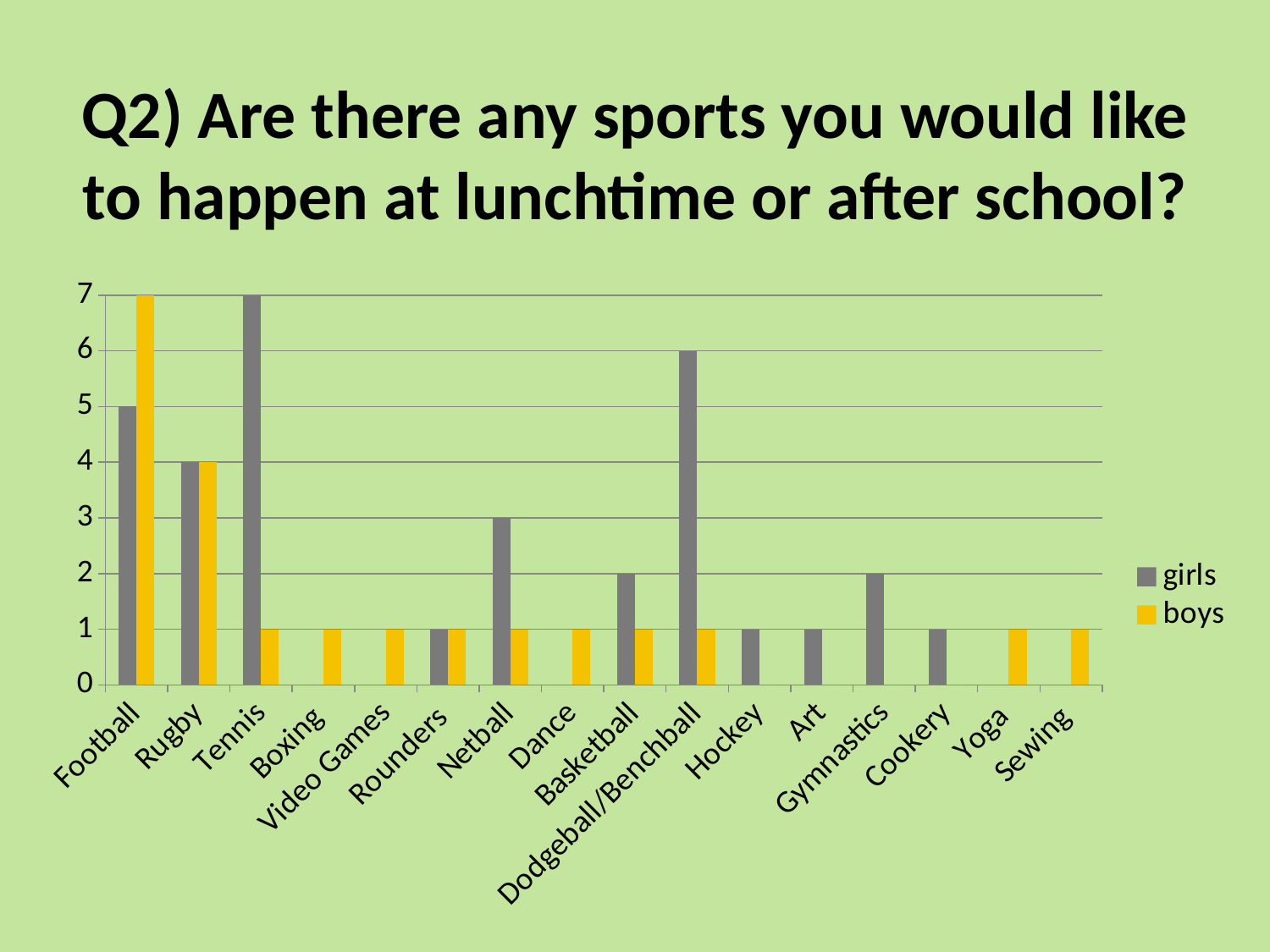
What is the difference between the boys and girls values for Football? 2 What is the value for girls for Netball? 3 How many sports/activities are shown on the x axis? 16 What is the value for girls for Tennis? 7 Which activity has the highest value for boys? Football What type of chart is shown on the slide? bar chart What is the value for boys for Football? 7 What is the value for girls for Dodgeball/Benchball? 6 How many series does the legend list? 2 Which activity has the highest value for girls? Tennis Which is larger: the girls value for Dodgeball/Benchball or the girls value for Basketball? Dodgeball/Benchball Which colour represents boys in the legend? yellow